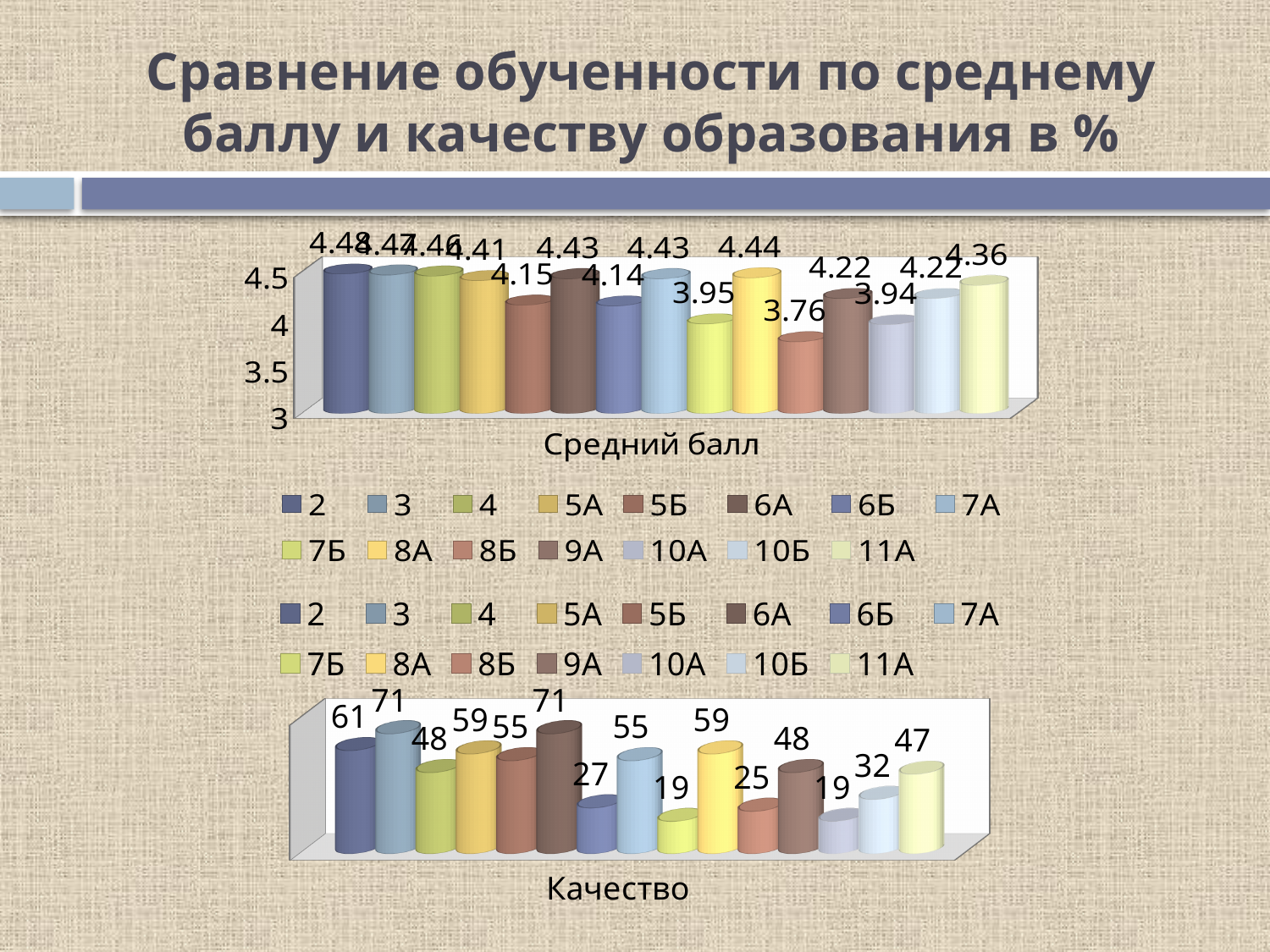
In the top chart (Средний балл), which series has the lowest value? 8Б How many series does the legend of the top chart (Средний балл) list? 15 In the top chart (Средний балл), what is the difference between the values for 8А and 7Б? 0.49 In the top chart (Средний балл), what is the value for 11А? 4.36 In the bottom chart (Качество), what is the difference between the values for 2 and 4? 13 In the bottom chart (Качество), what is the value for 10Б? 32 What kind of chart is the bottom chart (Качество)? Bar chart In the top chart (Средний балл), which is larger: the value for 9А or for 10А? 9А In the top chart (Средний балл), what is the value for 8Б? 3.76 In the bottom chart (Качество), which is larger: the value for 8А or for 8Б? 8А In the bottom chart (Качество), what is the value for 6Б? 27 What is the title shown under the top chart? Средний балл